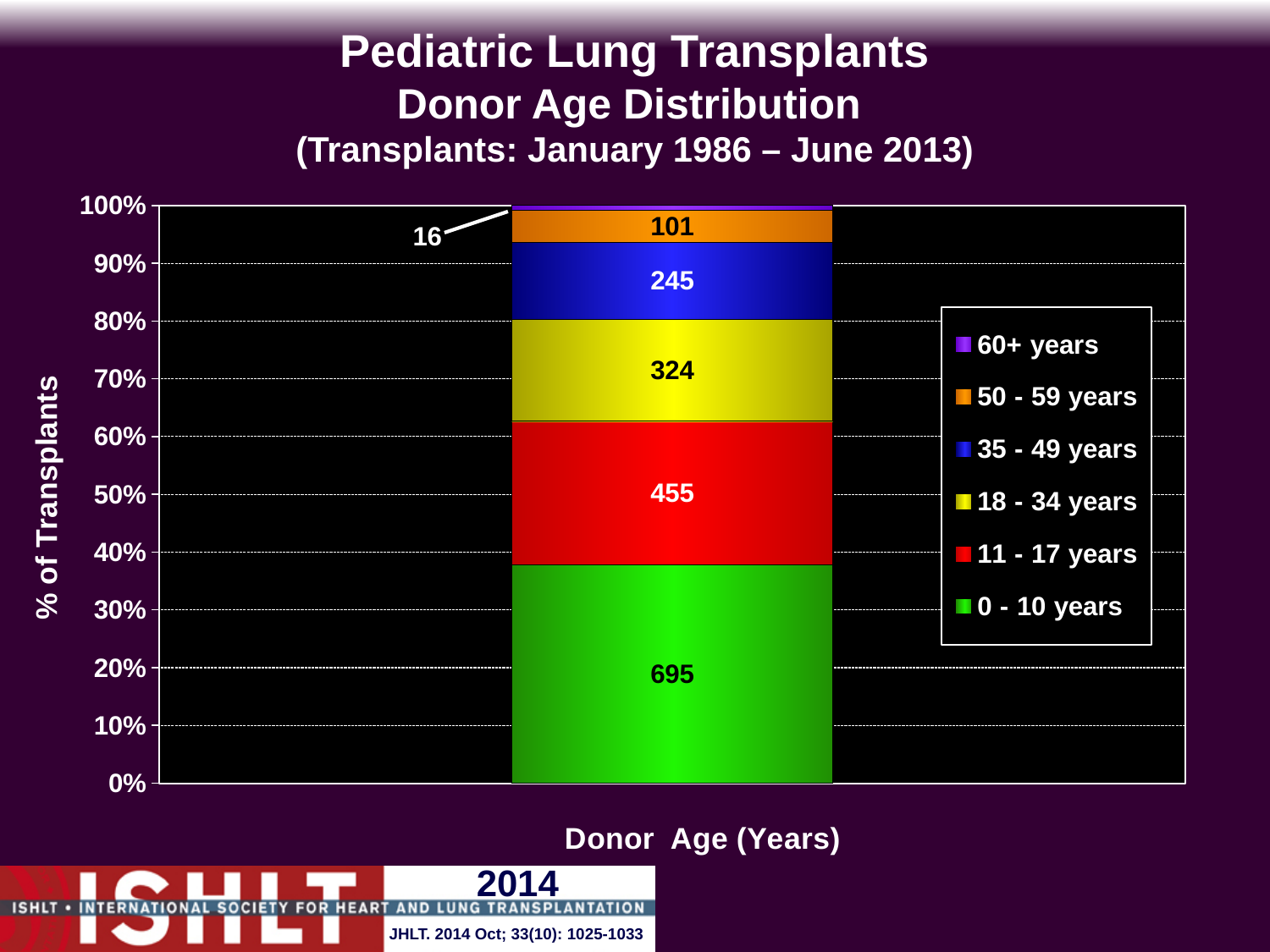
What is the number of transplants for donors aged 11 - 17 years? 455 What value is labelled for the 18 - 34 years segment? 324 How many transplants came from donors aged 35 - 49 years? 245 How many transplants are shown for the 0 - 10 years donor age group? 695 Which donor age group has the largest number of transplants? 0 - 10 years Which donor age group has the smallest number of transplants? 60+ years Is the share of transplants from the 0 - 10 years group greater or less than 40%? less What is the difference between the number of transplants for the 0 - 10 years group and the 11 - 17 years group? 240 Which has more transplants: the 35 - 49 years group or the 50 - 59 years group? 35 - 49 years How many donor age groups does the legend list? 6 What is the value for the 60+ years donor age group? 16 What is the total number of transplants across all donor age groups in the stacked bar? 1836